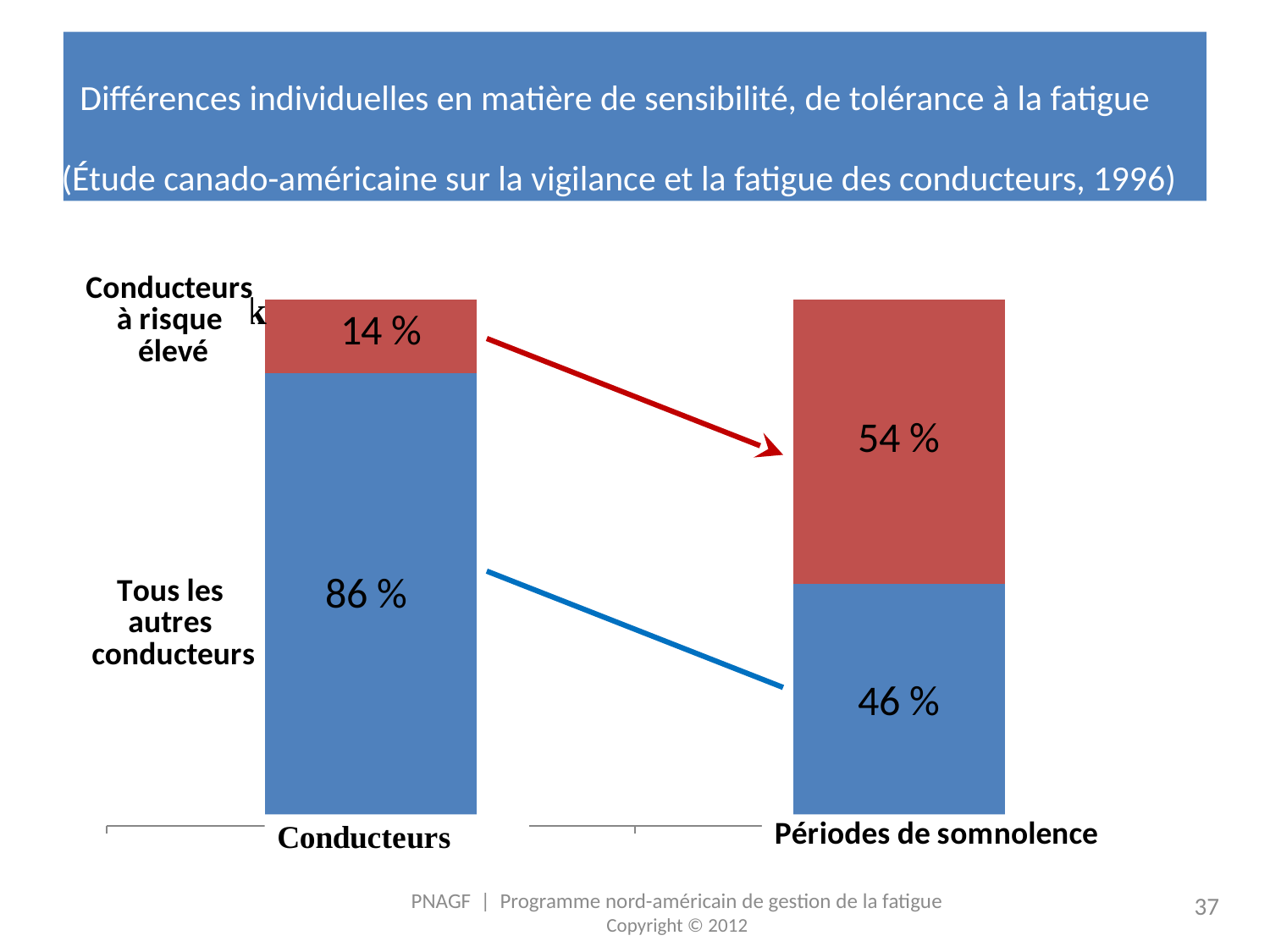
In the "Périodes de somnolence" bar, which segment is larger: "Conducteurs à risque élevé" or "Tous les autres conducteurs"? Conducteurs à risque élevé How many bars (categories) are shown in the chart? 2 What share of the "Conducteurs" bar is made up of "Conducteurs à risque élevé"? 14 % How many series (segments) does each stacked bar contain? 2 In the "Conducteurs" bar, which segment is larger: "Conducteurs à risque élevé" or "Tous les autres conducteurs"? Tous les autres conducteurs Which colour represents "Conducteurs à risque élevé" in the chart? Red What share of the "Périodes de somnolence" bar is attributed to "Conducteurs à risque élevé"? 54 % What share of the "Conducteurs" bar is made up of "Tous les autres conducteurs"? 86 % What kind of chart is shown on the slide? Stacked bar chart What share of the "Périodes de somnolence" bar is attributed to "Tous les autres conducteurs"? 46 % What is the total of the two segments in the "Conducteurs" bar? 100 % What is the difference between the "Conducteurs à risque élevé" share in the "Périodes de somnolence" bar and in the "Conducteurs" bar? 40 %